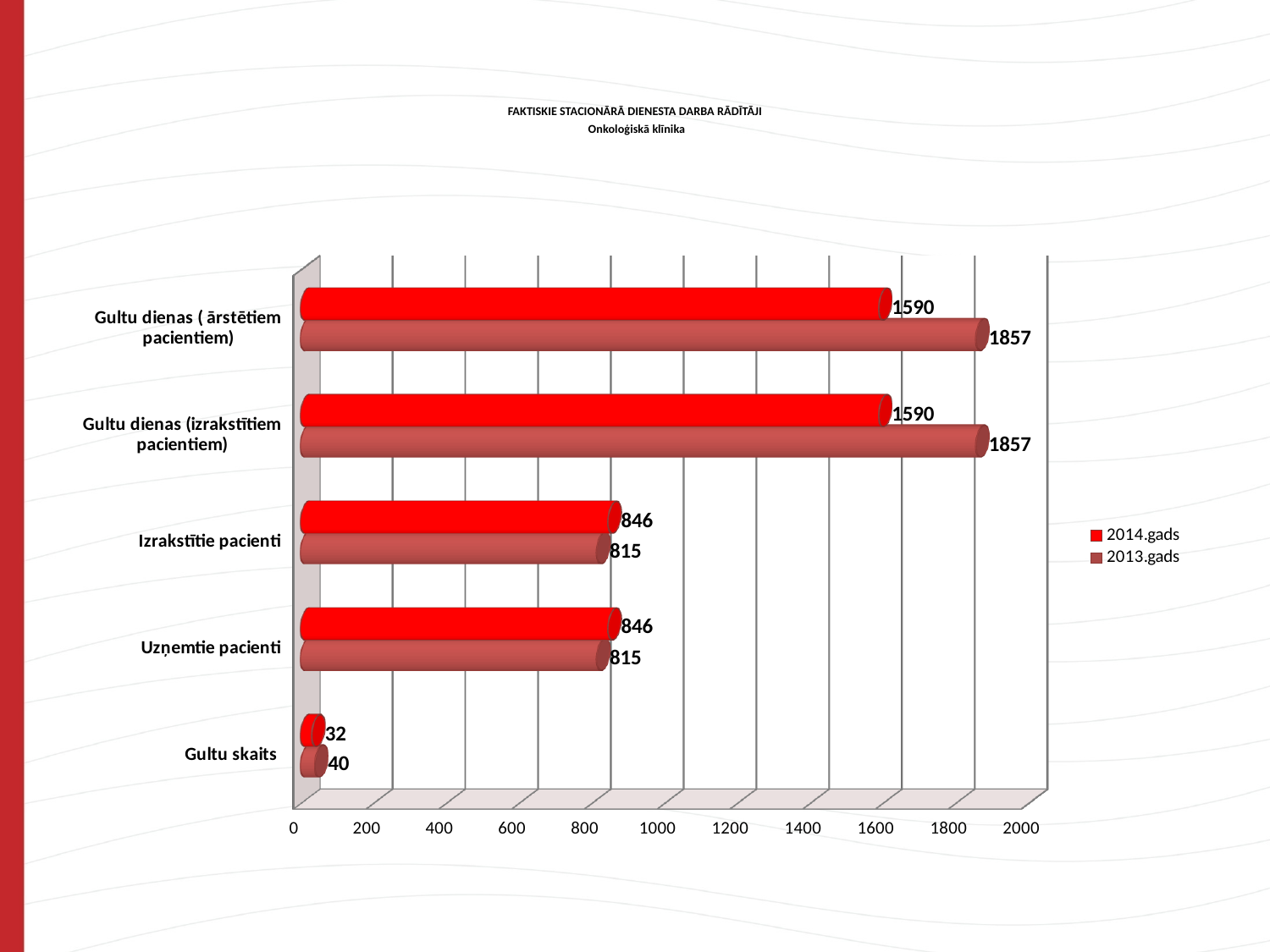
What is the value for Uzņemtie pacienti in 2014.gads? 846 What is the value for Gultu skaits in 2013.gads? 40 What is the value for Izrakstītie pacienti in 2013.gads? 815 What is the value for Gultu skaits in 2014.gads? 32 What is the difference between the 2013.gads and 2014.gads values for Gultu dienas ( ārstētiem pacientiem)? 267 How many categories are shown on the chart? 5 What kind of chart is shown on the slide? Bar chart What is the difference between the 2014.gads and 2013.gads values for Uzņemtie pacienti? 31 How many series does the legend list? 2 What is the value for Gultu dienas (izrakstītiem pacientiem) in 2013.gads? 1857 Which is larger for Izrakstītie pacienti: the 2014.gads value or the 2013.gads value? 2014.gads Which category has the lowest value in 2014.gads? Gultu skaits